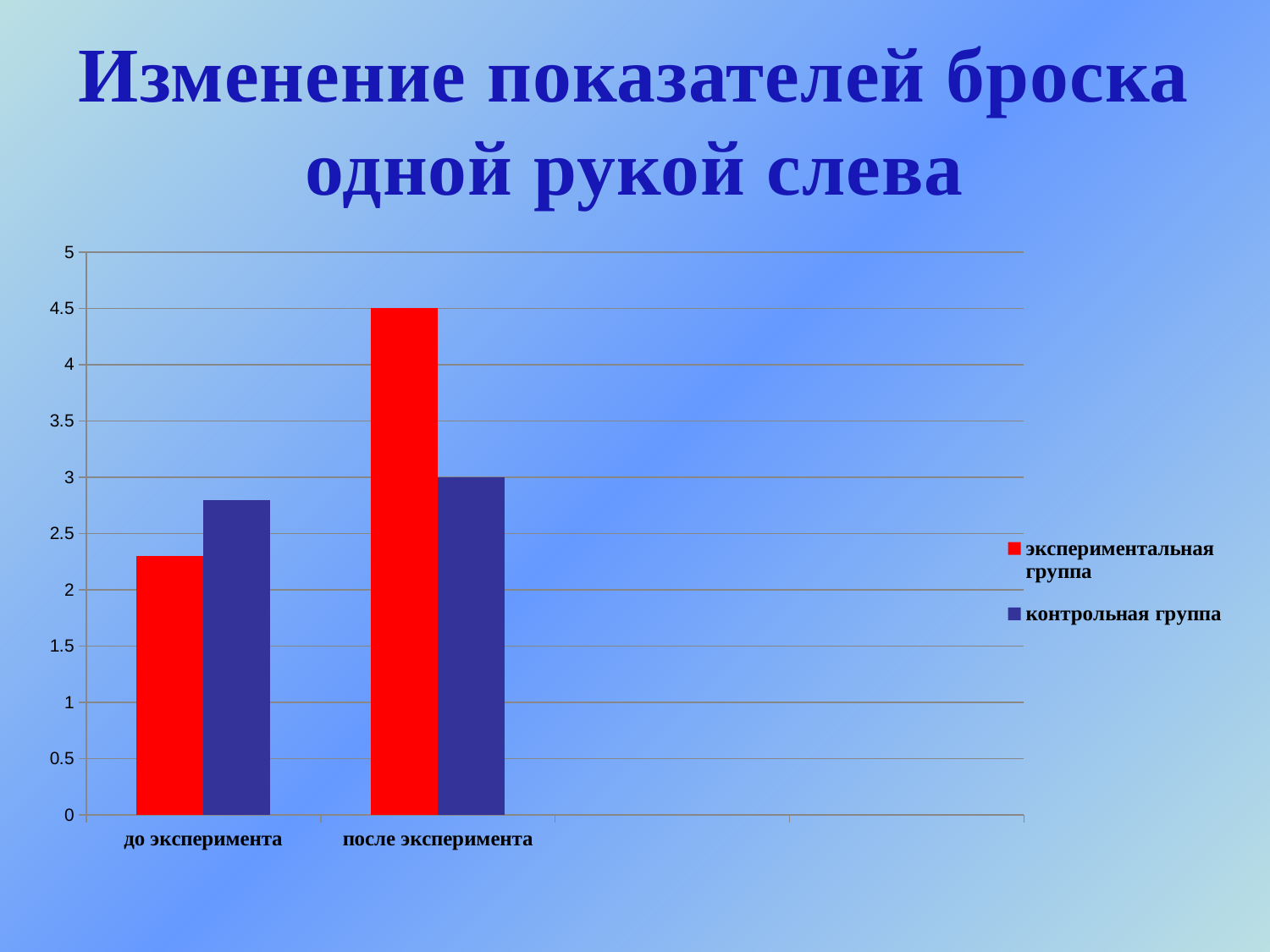
What is the difference between экспериментальная группа and контрольная группа после эксперимента? 1.5 Is the value for контрольная группа до эксперимента greater or less than 2.5? greater How many categories are shown on the x axis? 2 После эксперимента, which group has the larger value: экспериментальная группа or контрольная группа? экспериментальная группа Is the value for экспериментальная группа до эксперимента greater or less than 2.5? less How many series does the legend list? 2 What is the value for экспериментальная группа после эксперимента? 4.5 Does the value for экспериментальная группа rise or fall from до эксперимента to после эксперимента? rises What kind of chart is shown on the slide? bar chart Which bar is the highest in the chart? экспериментальная группа, после эксперимента До эксперимента, which group has the larger value: экспериментальная группа or контрольная группа? контрольная группа What is the value for контрольная группа после эксперимента? 3